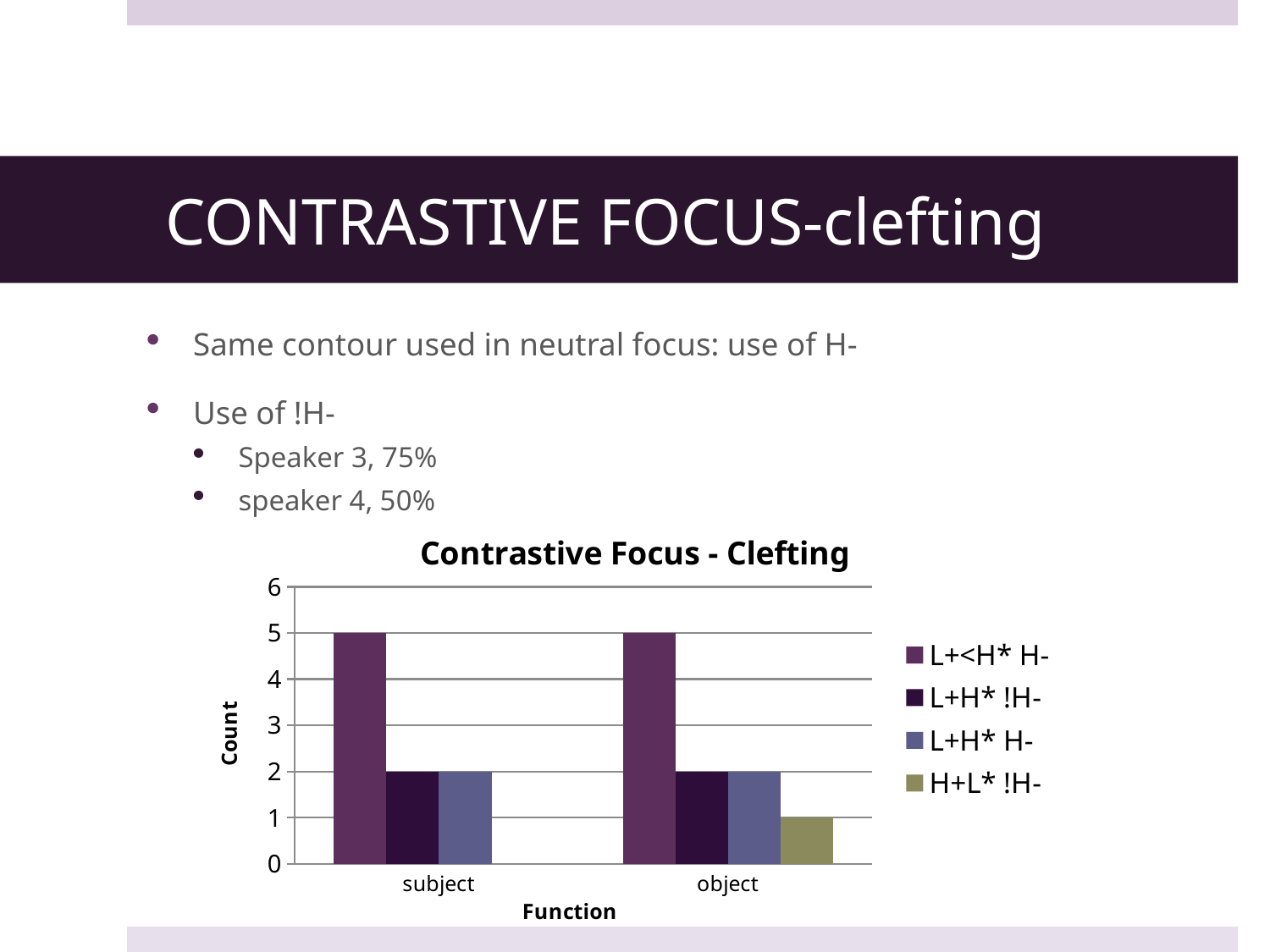
Which series has the lowest count in the object category? H+L* !H- What is the difference between the count for L+<H* H- and the count for L+H* !H- in the subject category? 3 Which is larger in the object category: the count for L+H* H- or the count for H+L* !H-? L+H* H- What kind of chart is shown on the slide? bar chart What is the count for L+<H* H- in the subject category? 5 How many series does the chart legend list? 4 What is the count for H+L* !H- in the object category? 1 Which series has the highest count in the object category? L+<H* H- What is the count for L+H* !H- in the object category? 2 What is the title of the chart? Contrastive Focus - Clefting What is the count for L+H* H- in the subject category? 2 How many categories are shown on the x axis of the chart? 2